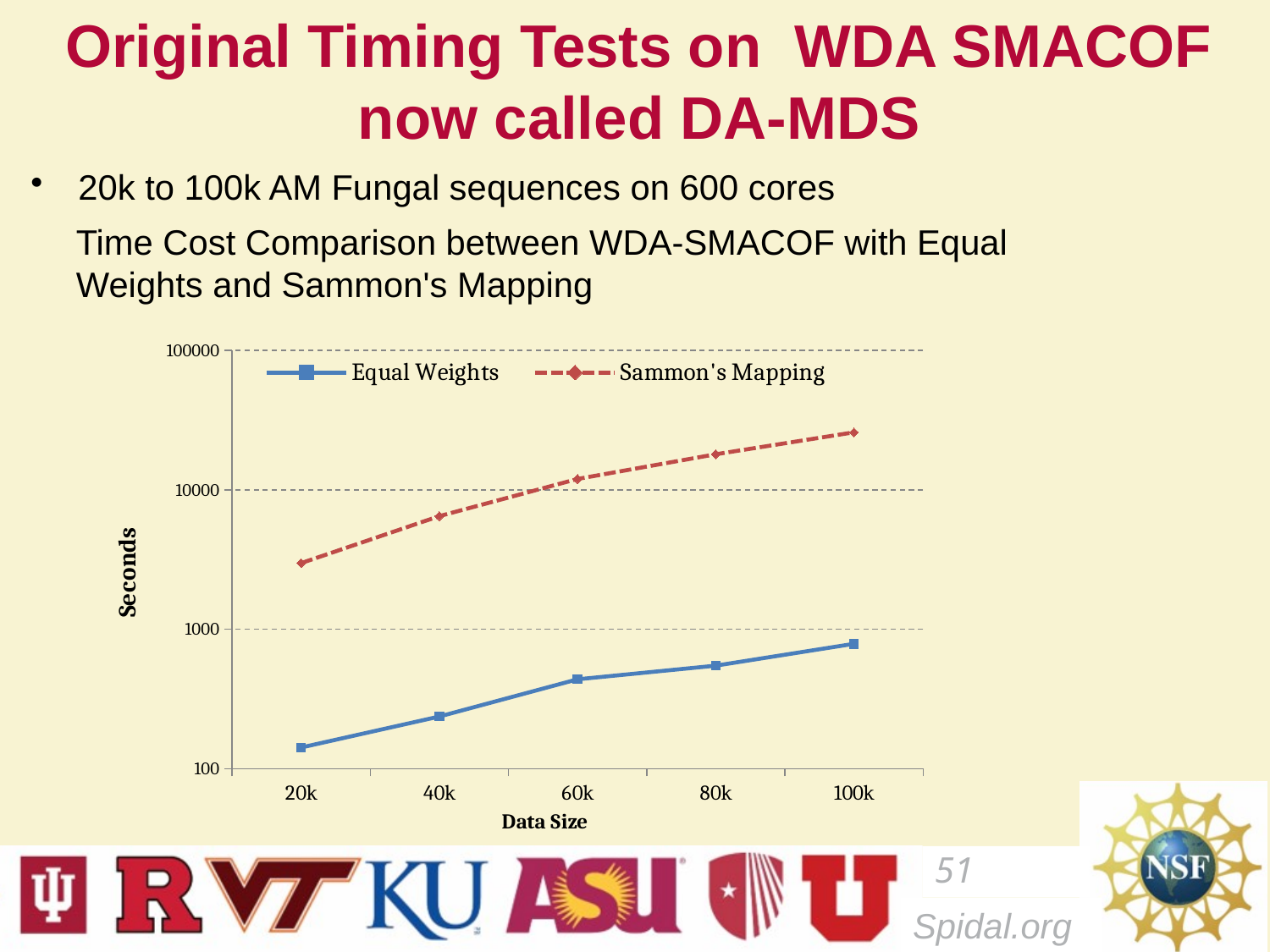
Is the value for Sammon's Mapping at 100k greater or less than 10000? greater What kind of chart is shown on the slide? line chart At which data size is the Equal Weights value highest? 100k What is the label of the y axis? Seconds Do the Sammon's Mapping values rise or fall as data size increases from 20k to 100k? rise Which series is plotted with a dashed red line? Sammon's Mapping At 60k, which series has the larger value, Equal Weights or Sammon's Mapping? Sammon's Mapping Is the value for Sammon's Mapping at 20k greater or less than 1000? greater How many series does the legend list? 2 How many data sizes are plotted along the x axis? 5 Is the value for Sammon's Mapping at 40k greater or less than 10000? less